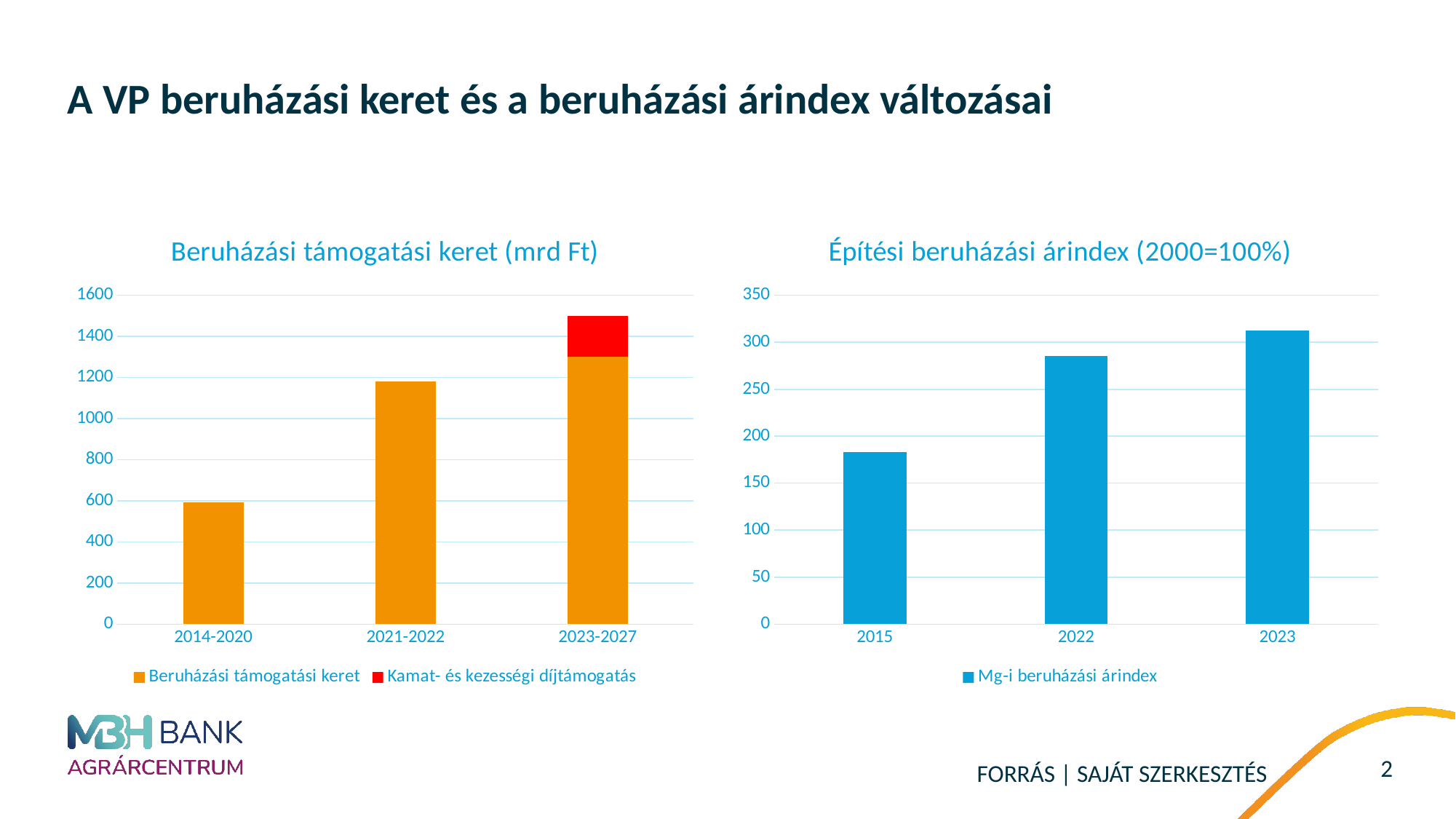
In the chart titled "Beruházási támogatási keret (mrd Ft)", is the Beruházási támogatási keret value for 2021-2022 greater or less than 1000? greater In the chart titled "Beruházási támogatási keret (mrd Ft)", which period has the highest total bar? 2023-2027 In the chart titled "Beruházási támogatási keret (mrd Ft)", how many series does the legend list? 2 In the chart titled "Építési beruházási árindex (2000=100%)", do the values rise or fall from 2015 to 2023? rise What kind of chart is the chart titled "Építési beruházási árindex (2000=100%)"? bar chart In the chart titled "Építési beruházási árindex (2000=100%)", which year has the highest value? 2023 In the chart titled "Beruházási támogatási keret (mrd Ft)", which period is the only one with a Kamat- és kezességi díjtámogatás segment? 2023-2027 In the chart titled "Építési beruházási árindex (2000=100%)", is the value for 2023 greater or less than 300? greater In the chart titled "Beruházási támogatási keret (mrd Ft)", is the value for 2014-2020 greater or less than 800? less In the chart titled "Beruházási támogatási keret (mrd Ft)", which period has the lowest bar? 2014-2020 In the chart titled "Építési beruházási árindex (2000=100%)", which year has the lowest value? 2015